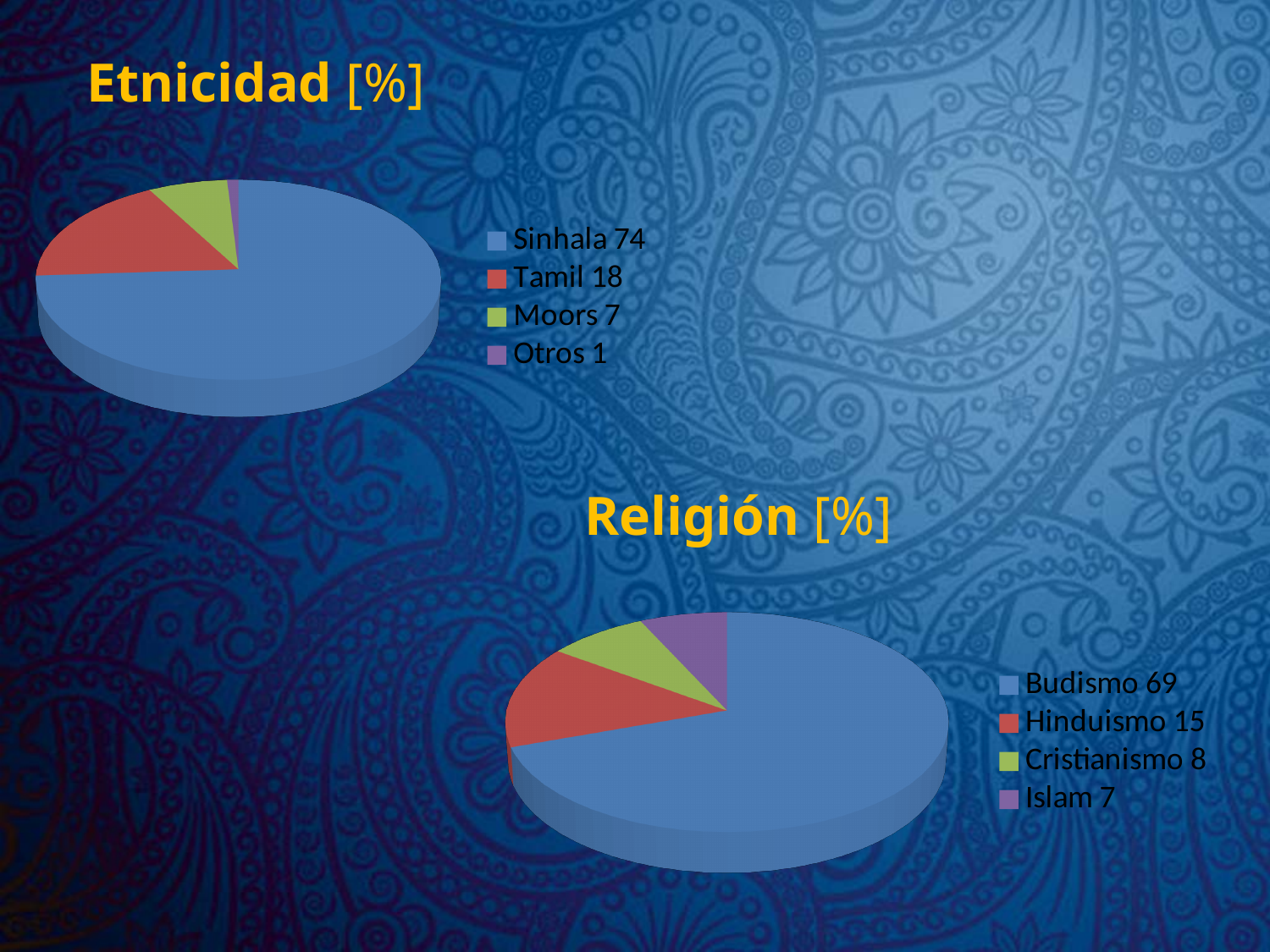
In the Religión [%] chart, what is the value for Budismo? 69 In the Religión [%] chart, which is larger, Hinduismo or Islam? Hinduismo In the Religión [%] chart, what is the value for Cristianismo? 8 What kind of chart is the Etnicidad [%] chart? Pie chart In the Religión [%] chart, what colour is the Islam slice? Purple In the Etnicidad [%] chart, how many categories does the legend list? 4 In the Etnicidad [%] chart, what is the difference between the Sinhala and Tamil values? 56 In the Etnicidad [%] chart, what is the value for Sinhala? 74 In the Religión [%] chart, what is the difference between the Budismo and Hinduismo values? 54 In the Etnicidad [%] chart, which category has the smallest slice? Otros In the Religión [%] chart, which category has the largest slice? Budismo In the Etnicidad [%] chart, what is the value for Tamil? 18